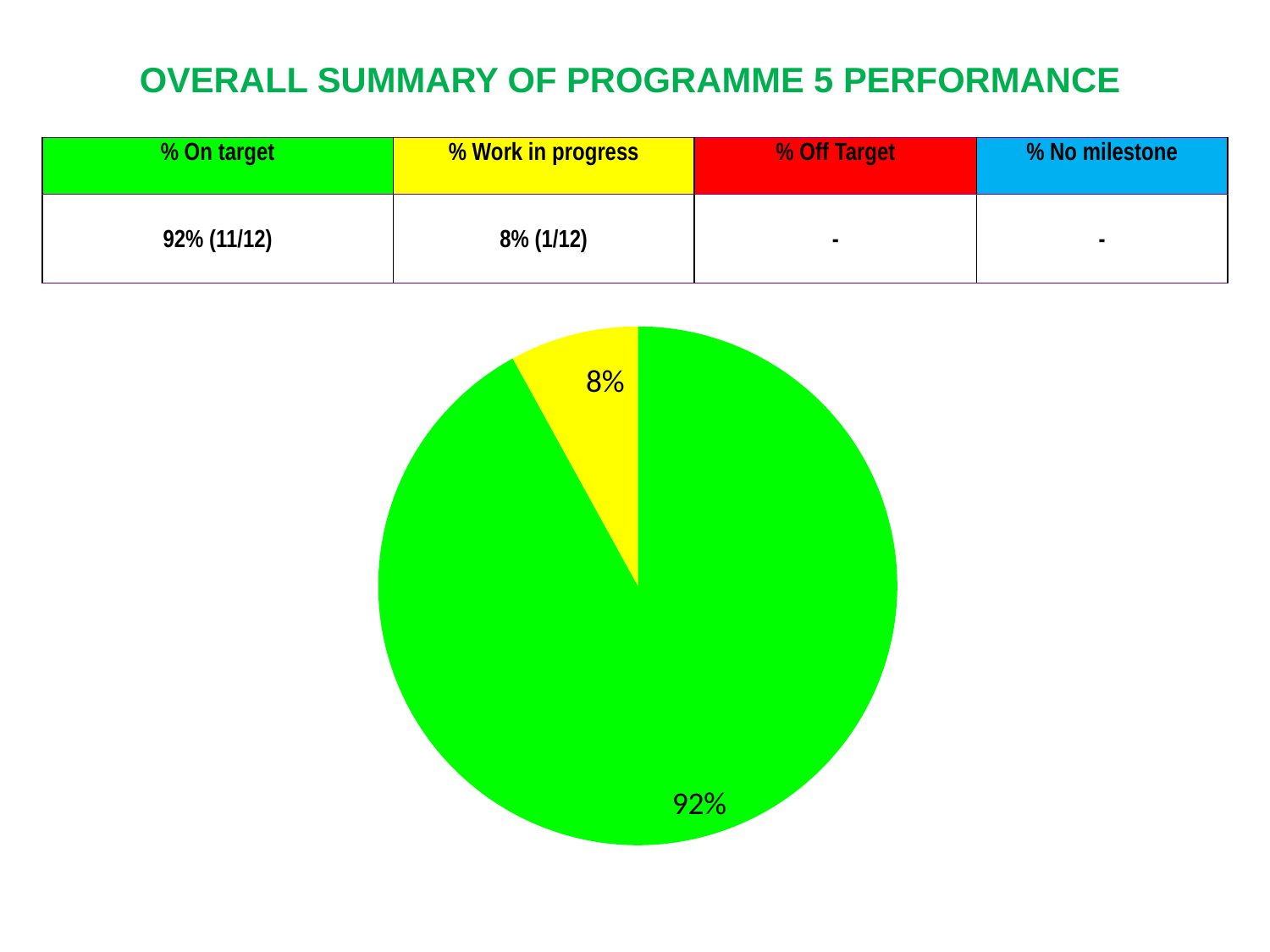
Using the colour key in the table above the chart, what share of the pie corresponds to '% On target'? 92% Which is larger, the green slice or the yellow slice? The green slice How many slices does the pie chart have? 2 What is the difference in percentage points between the green slice and the yellow slice? 84 percentage points What share of the pie does the green slice represent? 92% What kind of chart is shown on the slide? Pie chart What is the title shown at the top of the slide above the chart? OVERALL SUMMARY OF PROGRAMME 5 PERFORMANCE What colour is the largest slice of the pie chart? Green Which slice of the pie chart is the smallest? The yellow slice (8%) Which slice of the pie chart is the largest? The green slice (92%) Using the colour key in the table above the chart, what share of the pie corresponds to '% Work in progress'? 8% What share of the pie does the yellow slice represent? 8%